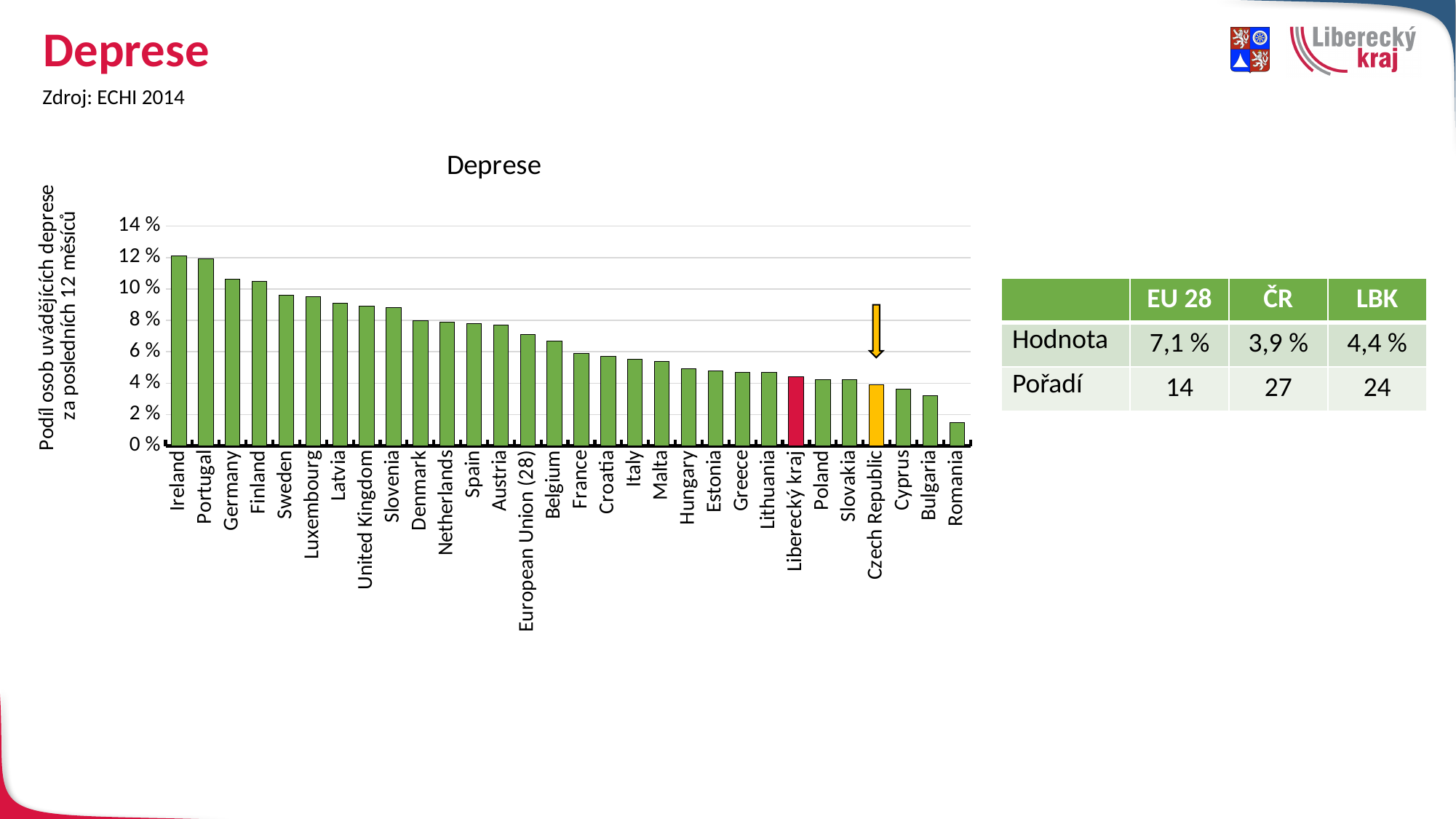
What is the value for Czech Republic? 3,9 % Is the value for Bulgaria greater or less than 4 %? less Which category has the lowest value in the chart? Romania Is the value for Ireland greater or less than 10 %? greater Do the values rise or fall from left to right along the x axis? fall What is the value for European Union (28)? 7,1 % How many categories (bars) are plotted in the chart? 30 Which is larger, the value for Liberecký kraj or the value for Czech Republic? Liberecký kraj What is the difference between the value for European Union (28) and the value for Czech Republic? 3,2 % What is the title of the chart? Deprese What kind of chart is shown on the slide? bar chart What is the value for Liberecký kraj? 4,4 %